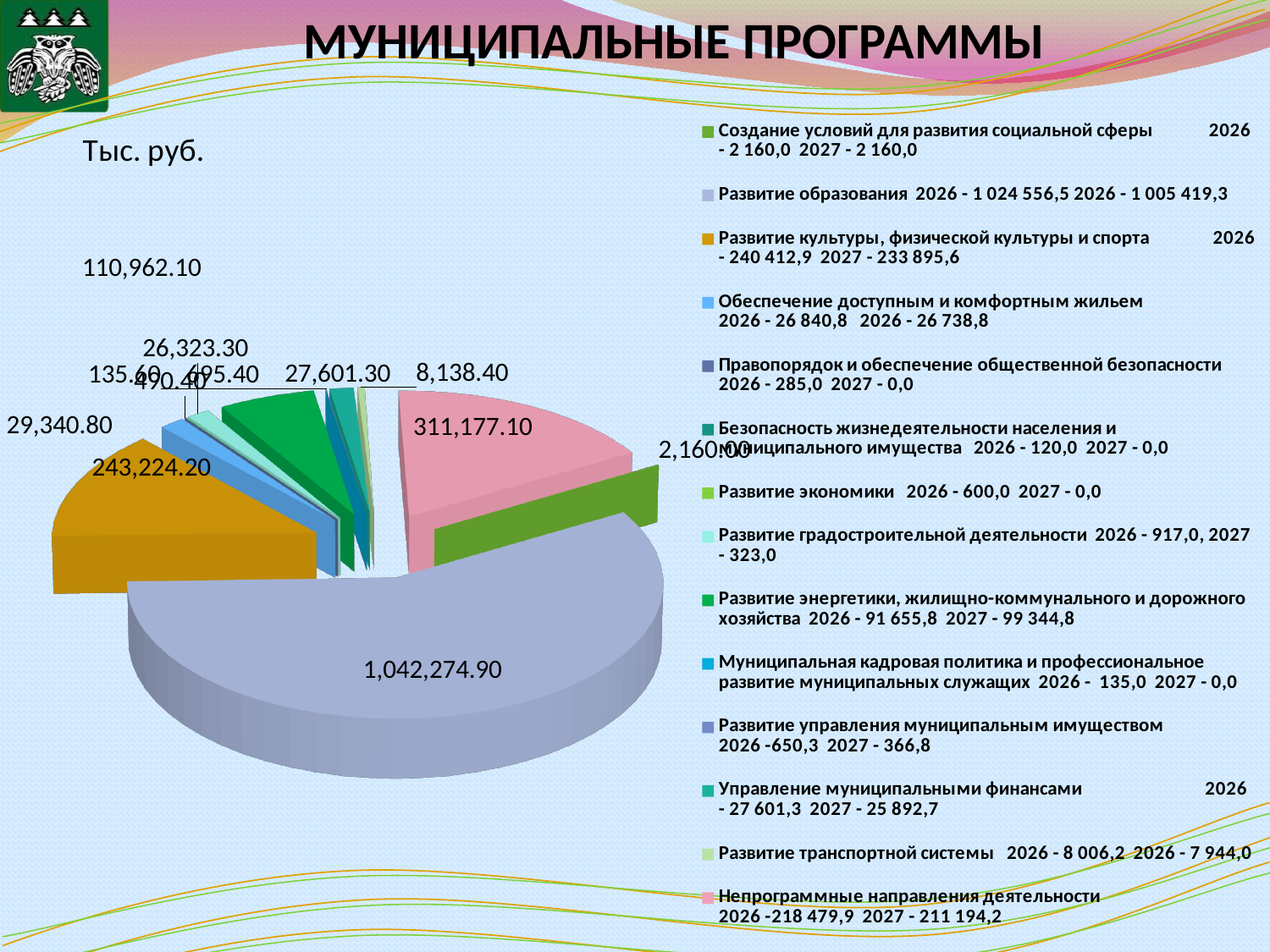
What is the difference between the largest slice (1,042,274.90) and the pink slice (311,177.10)? 731,097.80 What is the title of the slide containing the pie chart? МУНИЦИПАЛЬНЫЕ ПРОГРАММЫ Which is larger, the slice labelled 29,340.80 or the slice labelled 8,138.40? 29,340.80 What is the value shown on the gold slice of the pie chart? 243,224.20 What is the value of the largest slice in the pie chart? 1,042,274.90 Which is larger, the slice labelled 27,601.30 or the slice labelled 26,323.30? 27,601.30 What is the difference between the pink slice (311,177.10) and the gold slice (243,224.20)? 67,952.90 How many entries does the legend of the pie chart list? 14 What type of chart is shown on the slide? pie chart What is the value shown on the pink slice of the pie chart? 311,177.10 What unit is indicated for the values in the pie chart? Тыс. руб. What is the value shown on the large green slice of the pie chart? 110,962.10